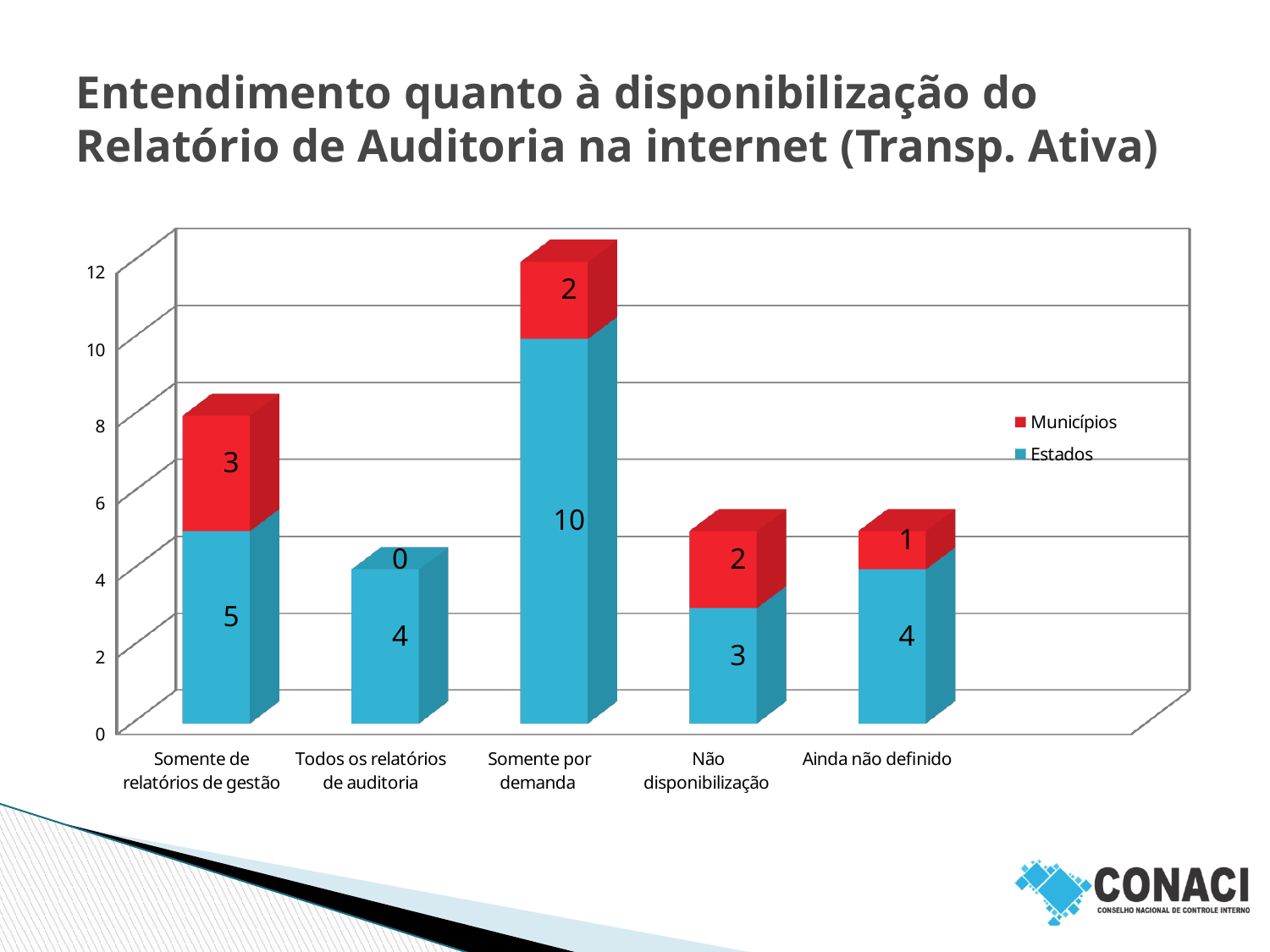
What is the value for Municípios in the 'Somente de relatórios de gestão' category? 3 What is the total of the stacked bar for 'Somente de relatórios de gestão'? 8 How many categories are shown on the x axis? 5 How many series does the legend list? 2 What is the value for Municípios in the 'Todos os relatórios de auditoria' category? 0 What is the value for Estados in the 'Não disponibilização' category? 3 Which category has the highest value for Estados? Somente por demanda What is the total of the stacked bar for 'Somente por demanda'? 12 Which is larger: the Estados value for 'Ainda não definido' or the Estados value for 'Não disponibilização'? Ainda não definido What is the value for Estados in the 'Somente por demanda' category? 10 What is the difference between the Estados values for 'Somente por demanda' and 'Somente de relatórios de gestão'? 5 Which category has the lowest value for Municípios? Todos os relatórios de auditoria